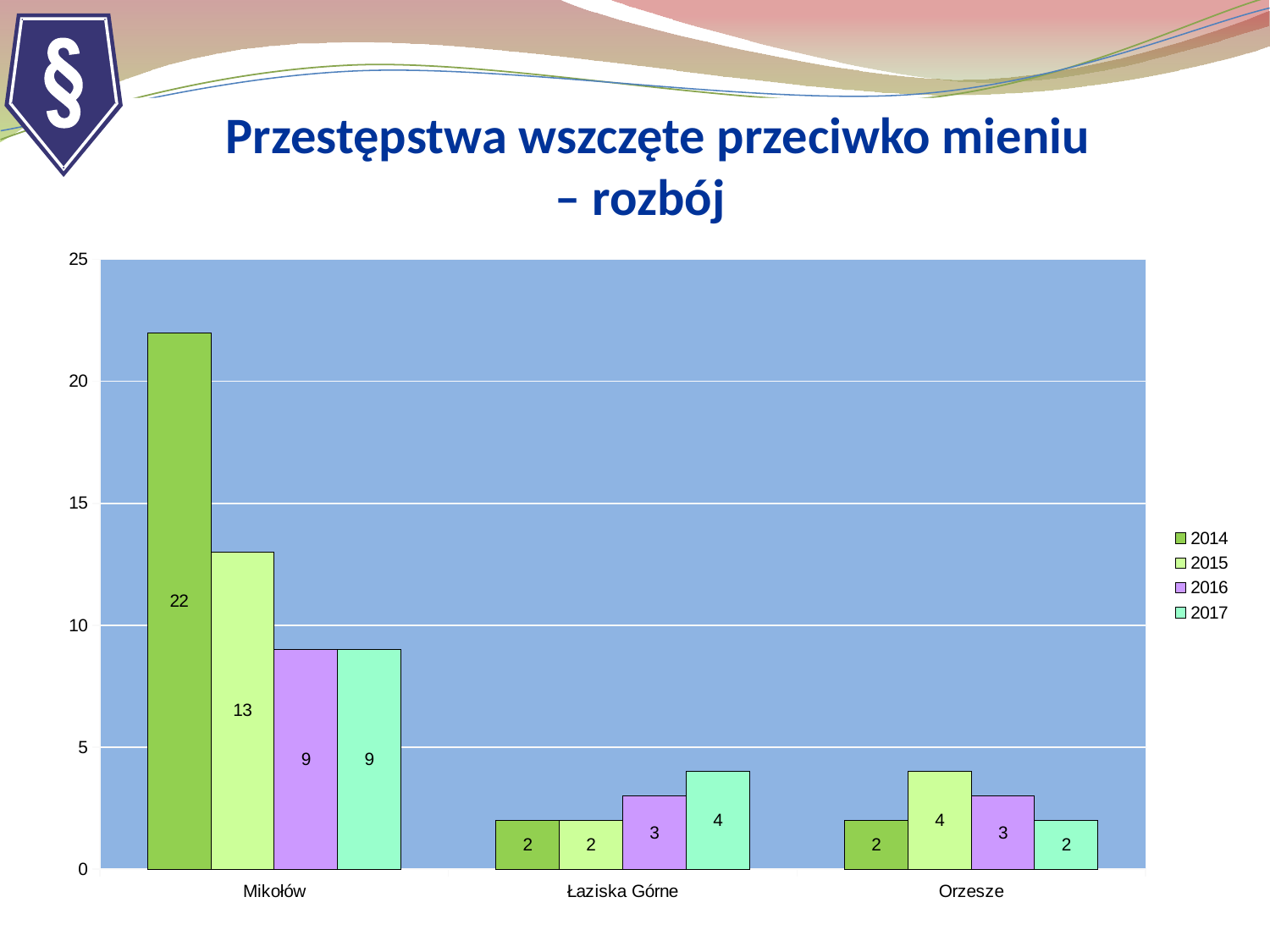
What is the value for Orzesze in 2015? 4 Which category has the highest value in 2014? Mikołów What is the difference between the 2014 and 2015 values for Mikołów? 9 How many categories are shown on the x axis? 3 What is the value for Mikołów in 2014? 22 What is the value for Łaziska Górne in 2017? 4 Which year has the lowest value for Orzesze? 2014 and 2017 Which is larger for Łaziska Górne: the 2016 value or the 2017 value? 2017 How many series does the legend list? 4 What is the title of the slide? Przestępstwa wszczęte przeciwko mieniu – rozbój Is the value for Mikołów in 2014 greater or less than 20? greater What kind of chart is shown on the slide? bar chart